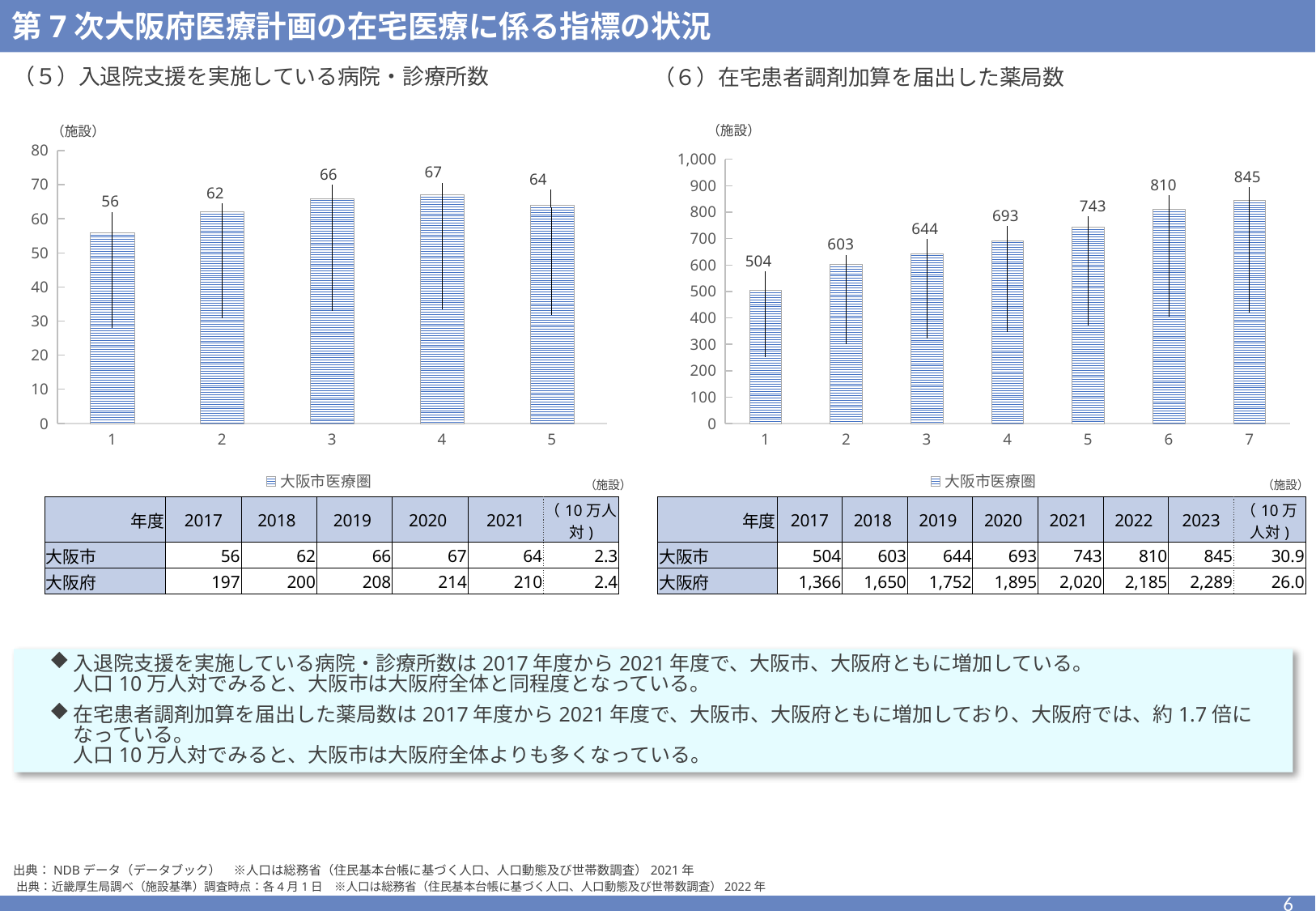
In the chart titled （５）入退院支援を実施している病院・診療所数, what is the difference between the values for category 4 and category 1? 11 In the chart titled （５）入退院支援を実施している病院・診療所数, what series name does the legend show? 大阪市医療圏 In the chart titled （６）在宅患者調剤加算を届出した薬局数, which is larger, the value for category 2 or category 3? category 3 In the chart titled （６）在宅患者調剤加算を届出した薬局数, which category has the highest value? 7 In the chart titled （６）在宅患者調剤加算を届出した薬局数, what is the difference between the values for category 7 and category 1? 341 In the chart titled （５）入退院支援を実施している病院・診療所数, how many bars are plotted? 5 In the chart titled （５）入退院支援を実施している病院・診療所数, which category has the lowest value? 1 In the chart titled （５）入退院支援を実施している病院・診療所数, which category has the highest value? 4 What kind of chart is the chart titled （６）在宅患者調剤加算を届出した薬局数? bar chart In the chart titled （５）入退院支援を実施している病院・診療所数, what is the value for category 3? 66 In the chart titled （６）在宅患者調剤加算を届出した薬局数, what is the value for category 5? 743 In the chart titled （６）在宅患者調剤加算を届出した薬局数, do the values rise or fall from category 1 to category 7? rise